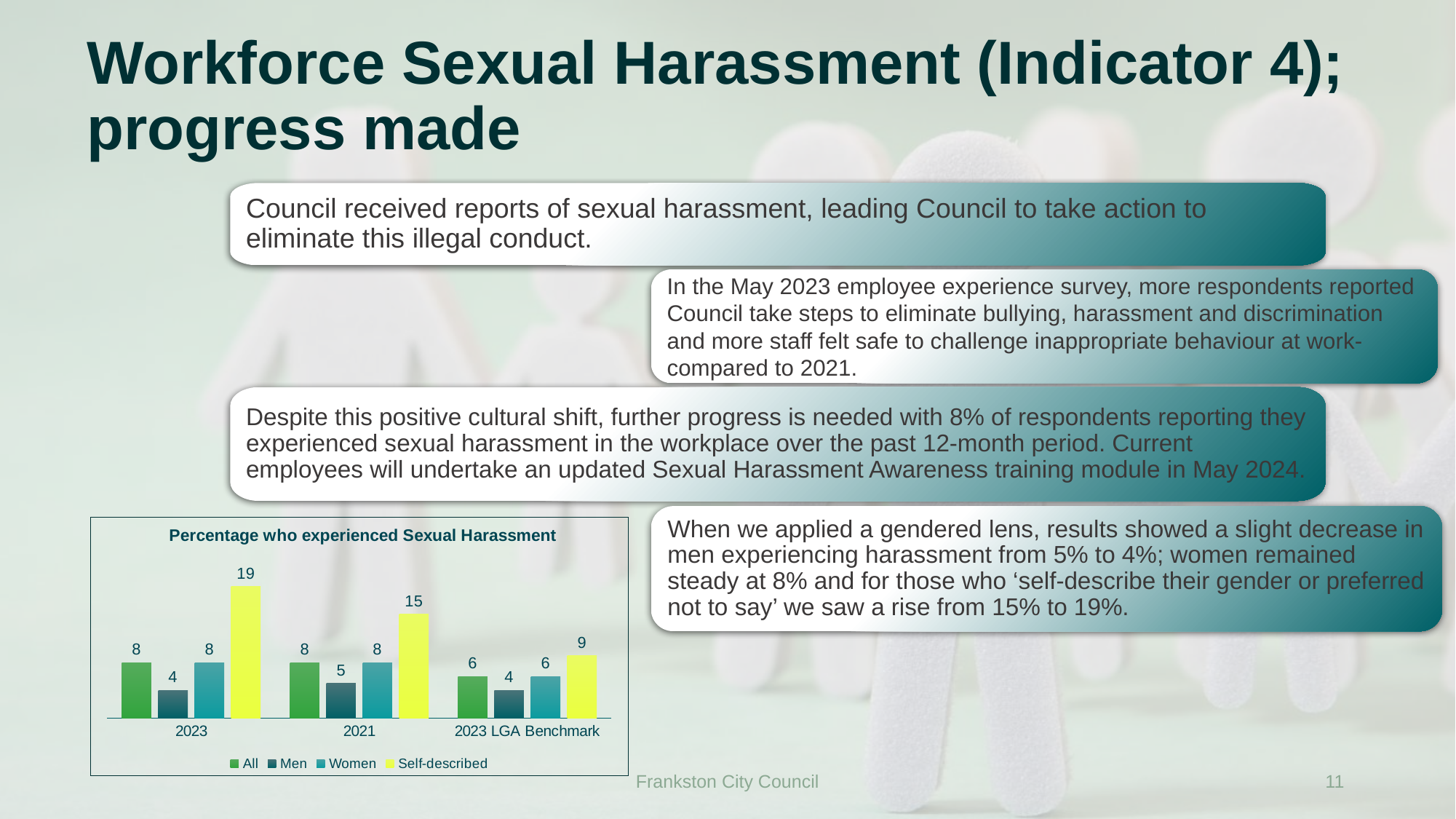
What is the title of the chart? Percentage who experienced Sexual Harassment What is the value for All in 2023? 8 What is the value for Self-described in 2023? 19 What kind of chart is shown on the slide? bar chart What is the difference between the Self-described values for 2023 and 2021? 4 Which series has the highest value in 2023? Self-described How many series does the legend list? 4 What is the value for Women in the 2023 LGA Benchmark? 6 What is the value for Men in 2021? 5 Is the Men value in 2021 larger or smaller than the Men value in 2023? larger How many categories are shown on the x axis? 3 Which series has the lowest value in the 2023 LGA Benchmark? Men